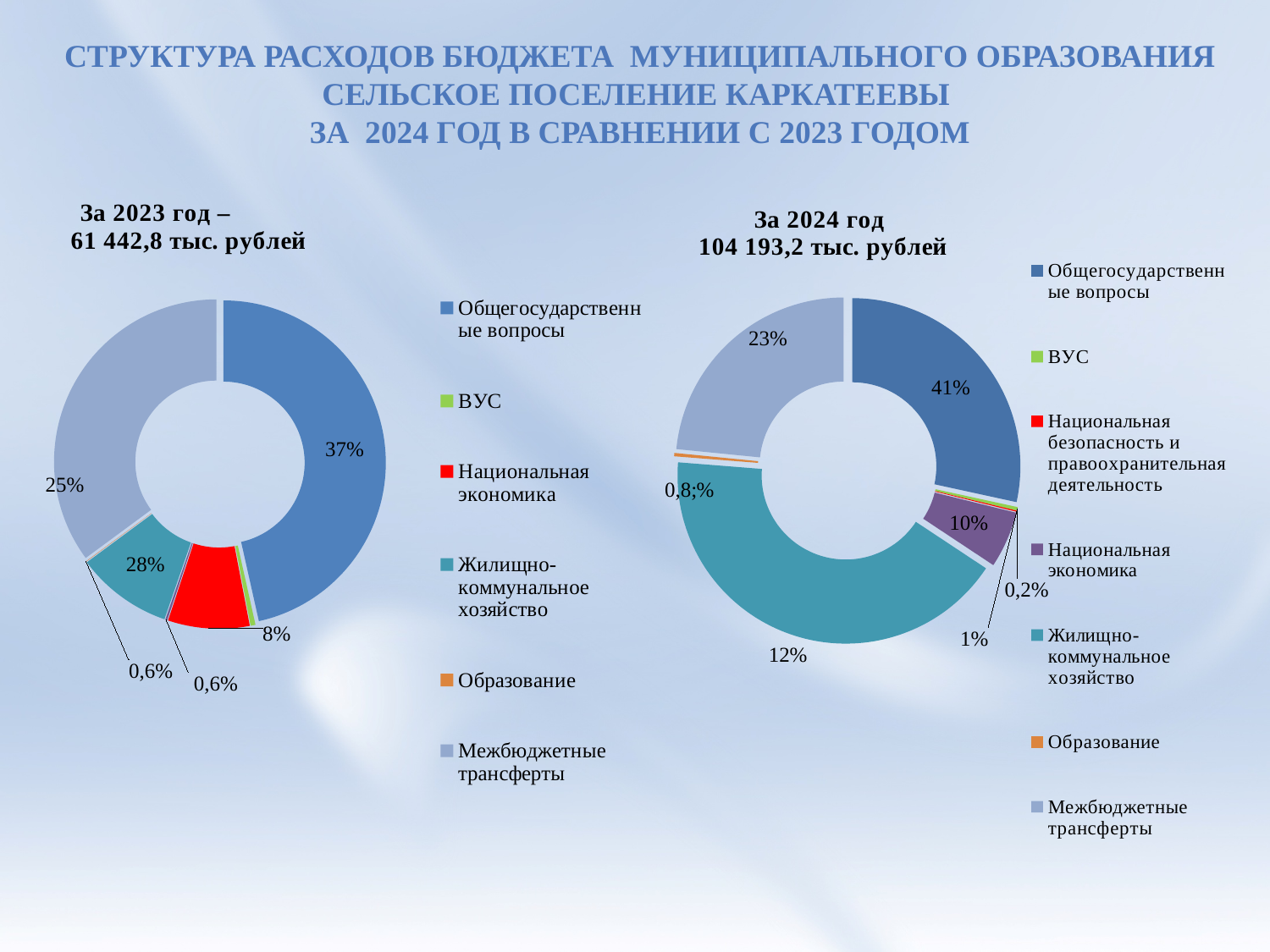
In the 2024 chart (right), which is larger: Общегосударственные вопросы or Межбюджетные трансферты? Общегосударственные вопросы In the 2023 chart (left), what share is shown for Общегосударственные вопросы? 37% How many categories does the legend of the 2023 chart (left) list? 6 In the 2024 chart (right), what share is shown for Межбюджетные трансферты? 23% In the 2023 chart (left), what share is shown for Межбюджетные трансферты? 25% In the 2024 chart (right), what share is shown for Общегосударственные вопросы? 41% In the 2024 chart (right), what share is shown for Национальная экономика? 10% What kind of chart is used on this slide to show the budget expenditure structure? pie (doughnut) chart What total expenditure amount is given in the title of the 2024 chart (right)? 104 193,2 тыс. рублей How many categories does the legend of the 2024 chart (right) list? 7 In the 2024 chart (right), what is the difference between the shares of Общегосударственные вопросы and Межбюджетные трансферты? 18%